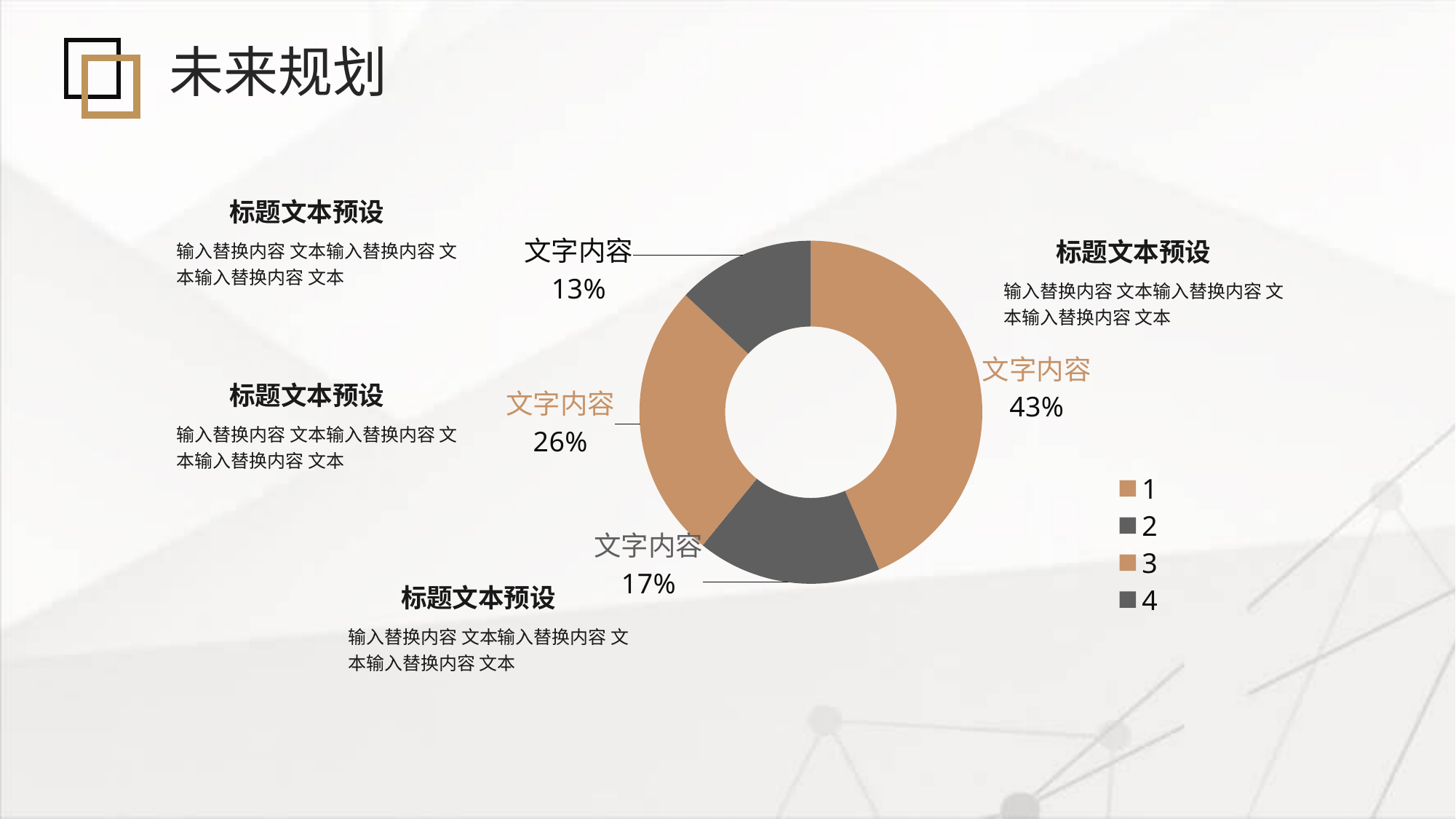
Which legend category has the largest slice in the doughnut chart? 1 Which legend category has the smallest slice in the doughnut chart? 4 What percentage is shown for legend category 4 in the doughnut chart? 13% How many slices does the doughnut chart have? 4 What percentage is shown for legend category 3 in the doughnut chart? 26% What type of chart is shown on the slide? Doughnut (pie) chart What percentage is shown for legend category 2 in the doughnut chart? 17% Which is larger in the doughnut chart: the slice for category 2 or the slice for category 3? 3 What colour is the slice for legend category 2 in the doughnut chart? Gray What percentage is shown for legend category 1 in the doughnut chart? 43% How many entries does the legend of the doughnut chart list? 4 What is the difference in percentage points between the largest slice (43%) and the smallest slice (13%)? 30